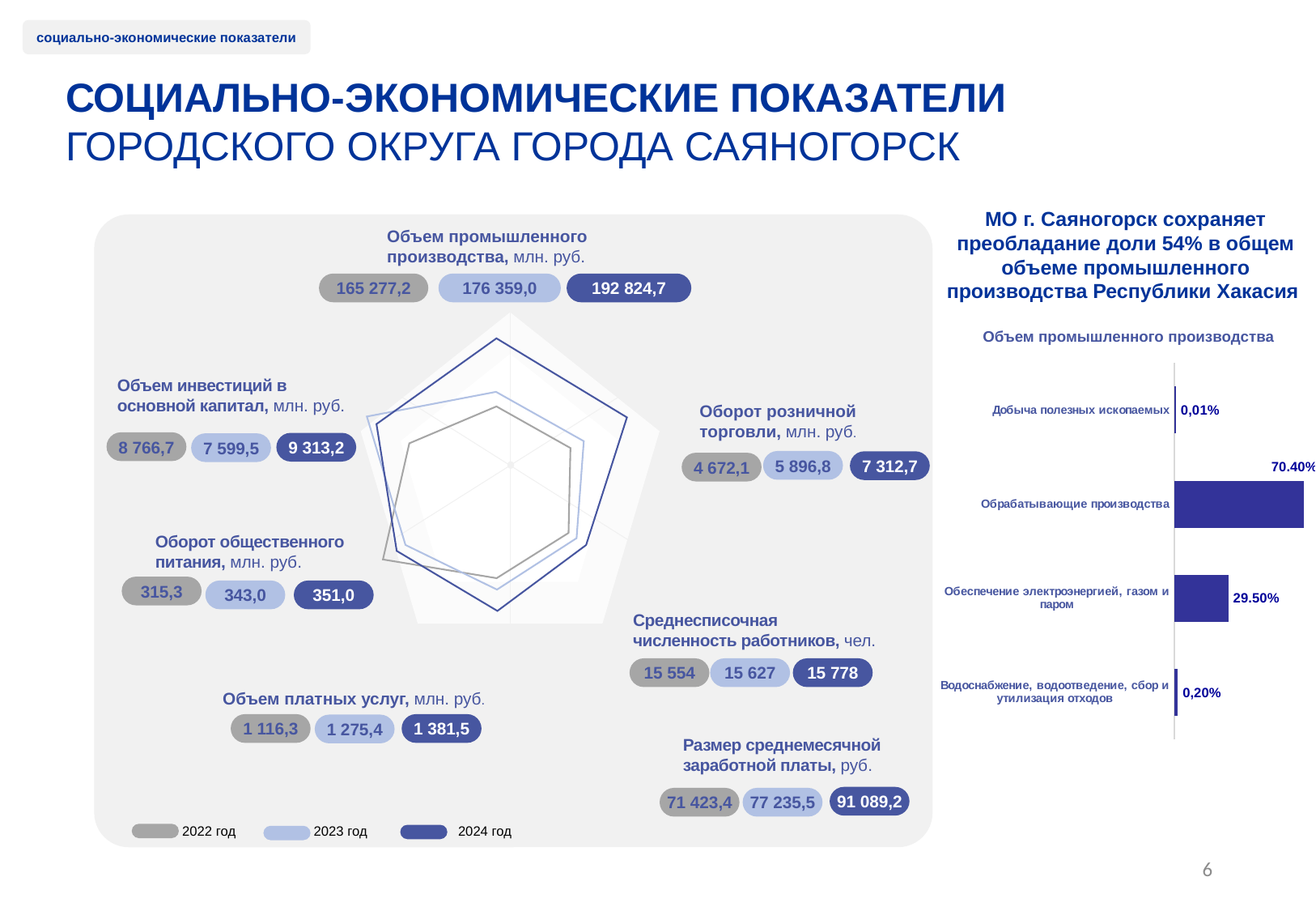
On the chart titled Объем промышленного производства on the right, what is the value for Обеспечение электроэнергией, газом и паром? 29.50% On the chart titled Объем промышленного производства on the right, which category has the highest share? Обрабатывающие производства On the radar chart on the left, do the values of Среднесписочная численность работников rise or fall from 2022 to 2024? rise On the radar chart on the left, what is the Размер среднемесячной заработной платы for 2023 год? 77 235,5 On the chart titled Объем промышленного производства on the right, which category has the lowest share? Добыча полезных ископаемых On the radar chart on the left, what is the difference between the 2024 and 2022 values of Оборот общественного питания? 35,7 On the radar chart on the left, which is larger: Объем инвестиций в основной капитал in 2022 год or in 2023 год? 2022 год On the radar chart on the left, how many series does the legend list? 3 What kind of chart is the chart titled Объем промышленного производства on the right? bar chart On the radar chart on the left, what is the value of Оборот розничной торговли for 2022 год? 4 672,1 On the radar chart on the left, what is the value of Объем промышленного производства for 2024 год? 192 824,7